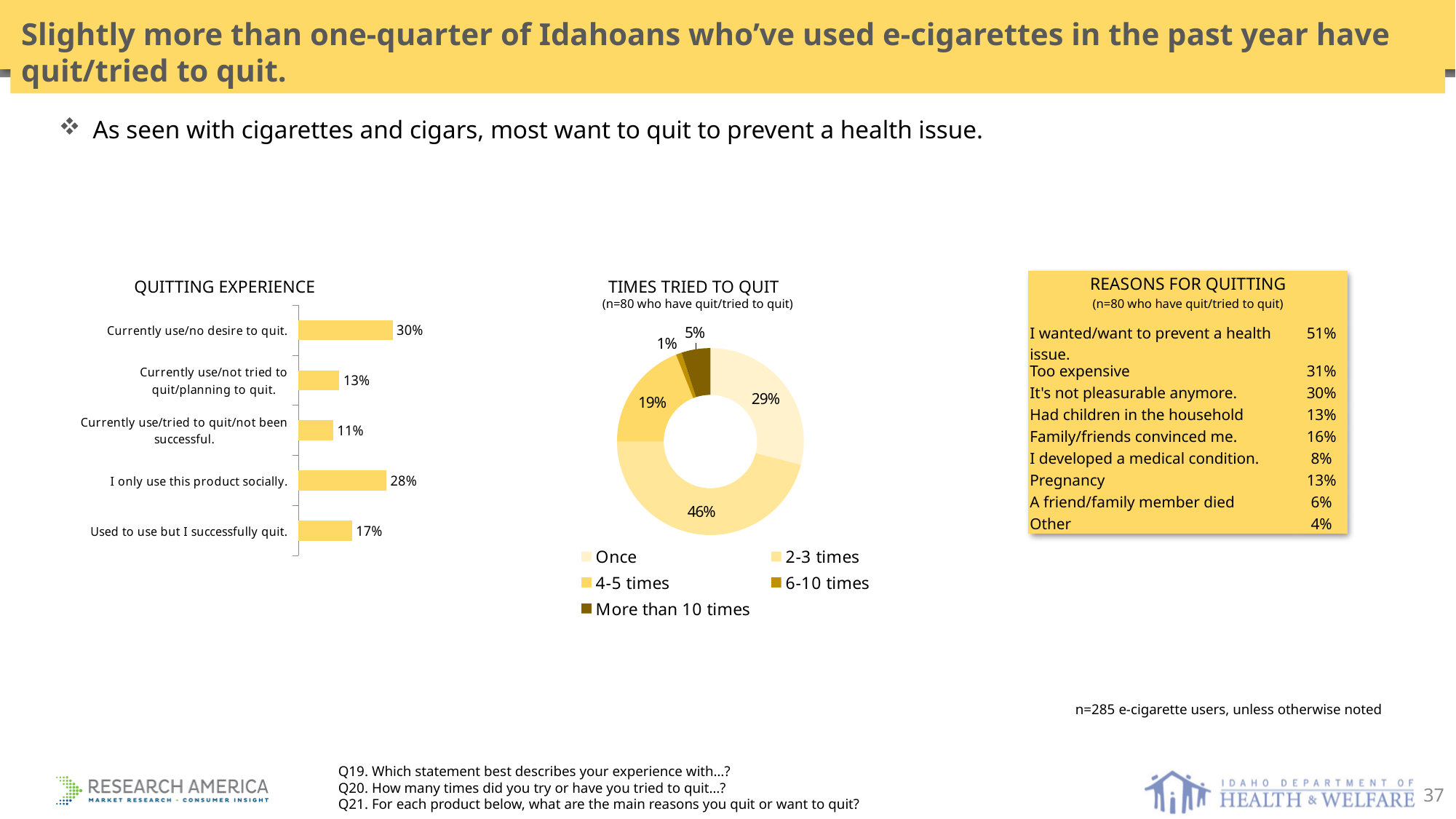
In the QUITTING EXPERIENCE chart, what is the value for "Used to use but I successfully quit."? 17% In the TIMES TRIED TO QUIT chart, what share is "2-3 times"? 46% In the QUITTING EXPERIENCE chart, what is the value for "Currently use/no desire to quit."? 30% In the QUITTING EXPERIENCE chart, which category has the lowest value? Currently use/tried to quit/not been successful. In the QUITTING EXPERIENCE chart, how many categories are shown? 5 What kind of chart is the QUITTING EXPERIENCE chart? Bar chart In the TIMES TRIED TO QUIT chart, what share is "Once"? 29% In the TIMES TRIED TO QUIT chart, which is larger: "4-5 times" or "More than 10 times"? 4-5 times How many entries does the legend of the TIMES TRIED TO QUIT chart list? 5 In the QUITTING EXPERIENCE chart, what is the difference between "I only use this product socially." and "Currently use/not tried to quit/planning to quit."? 15% In the QUITTING EXPERIENCE chart, which category has the highest value? Currently use/no desire to quit. In the TIMES TRIED TO QUIT chart, which category has the smallest share? 6-10 times